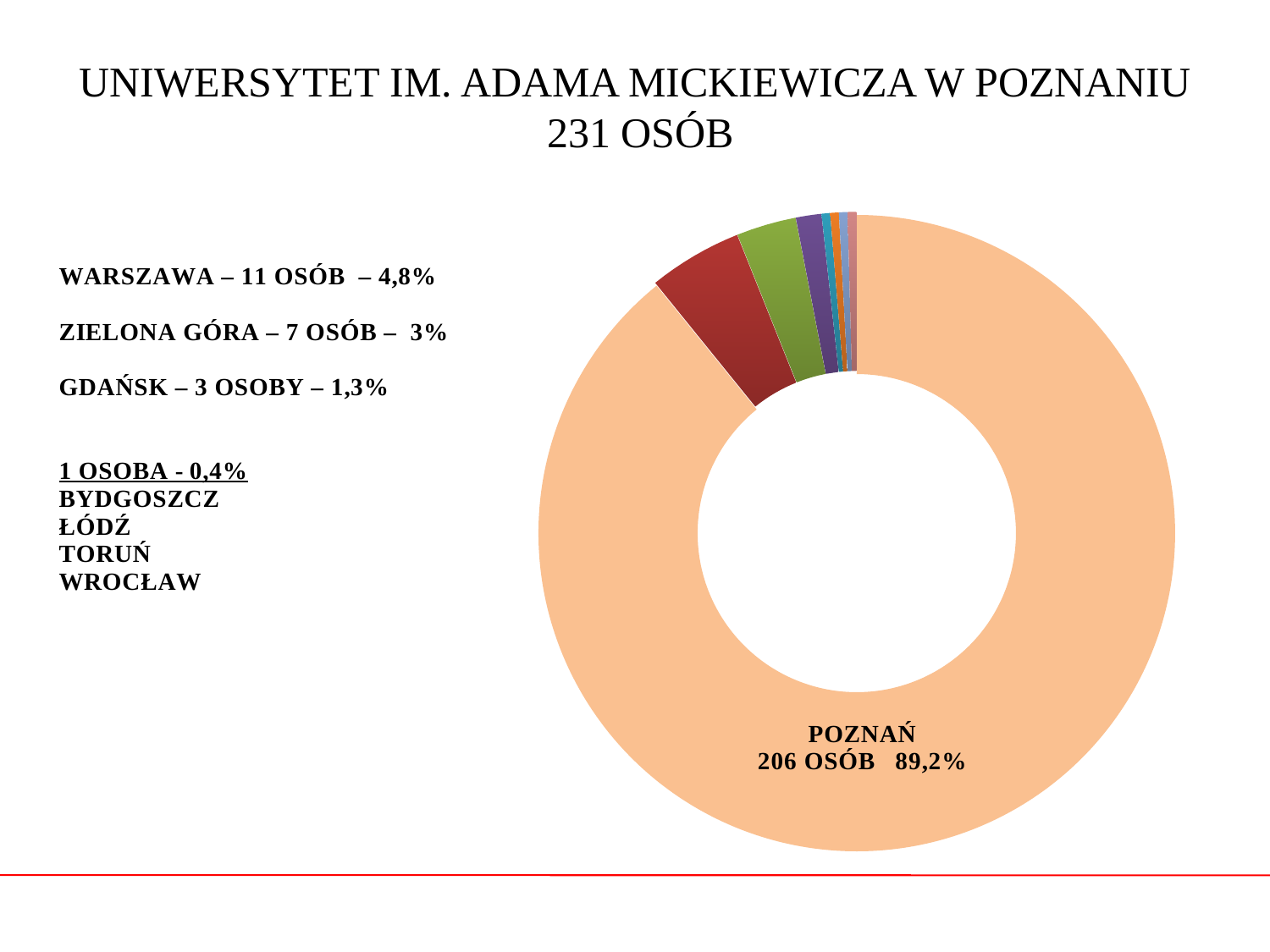
What percentage share does Bydgoszcz have? 0,4% How many more people are from Poznań than from Warszawa? 195 How many people are from Warszawa according to the slide? 11 osób How many people are from Gdańsk? 3 osoby Which has more people, Warszawa or Zielona Góra? Warszawa What is the difference in the number of people between Warszawa and Gdańsk? 8 What kind of chart is shown on the slide? Pie chart (donut) How many people does the Poznań slice of the pie chart represent? 206 osób What percentage share does Zielona Góra have? 3% What is the total number of people given in the slide title? 231 osób What percentage share does Poznań have in the pie chart? 89,2% Which city has the largest slice of the pie chart? Poznań